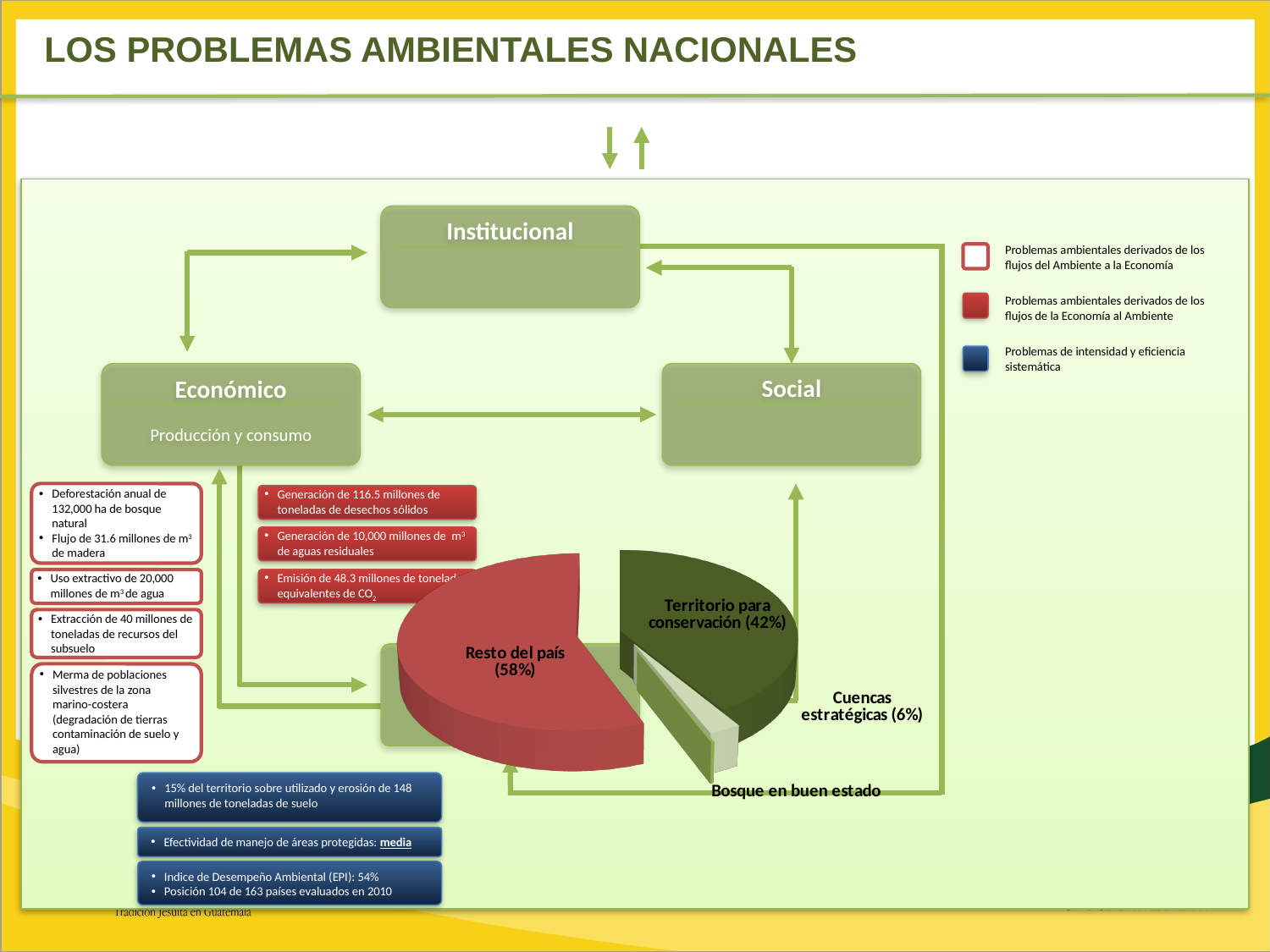
How many labelled slices does the pie chart have? 4 What percentage is shown for "Cuencas estratégicas" in the pie chart? 6% What label appears below the pie chart, next to the light green slice? Bosque en buen estado By how many percentage points does "Resto del país" exceed "Territorio para conservación" in the pie chart? 16 What percentage is shown for "Territorio para conservación" in the pie chart? 42% Which is larger in the pie chart, "Resto del país" or "Territorio para conservación"? Resto del país What share of the pie chart is labelled "Resto del país"? 58% Which labelled slice of the pie chart has the smallest percentage? Cuencas estratégicas Which slice of the pie chart is the largest? Resto del país What kind of chart is shown on the slide? pie chart What colour is the "Resto del país" slice in the pie chart? red